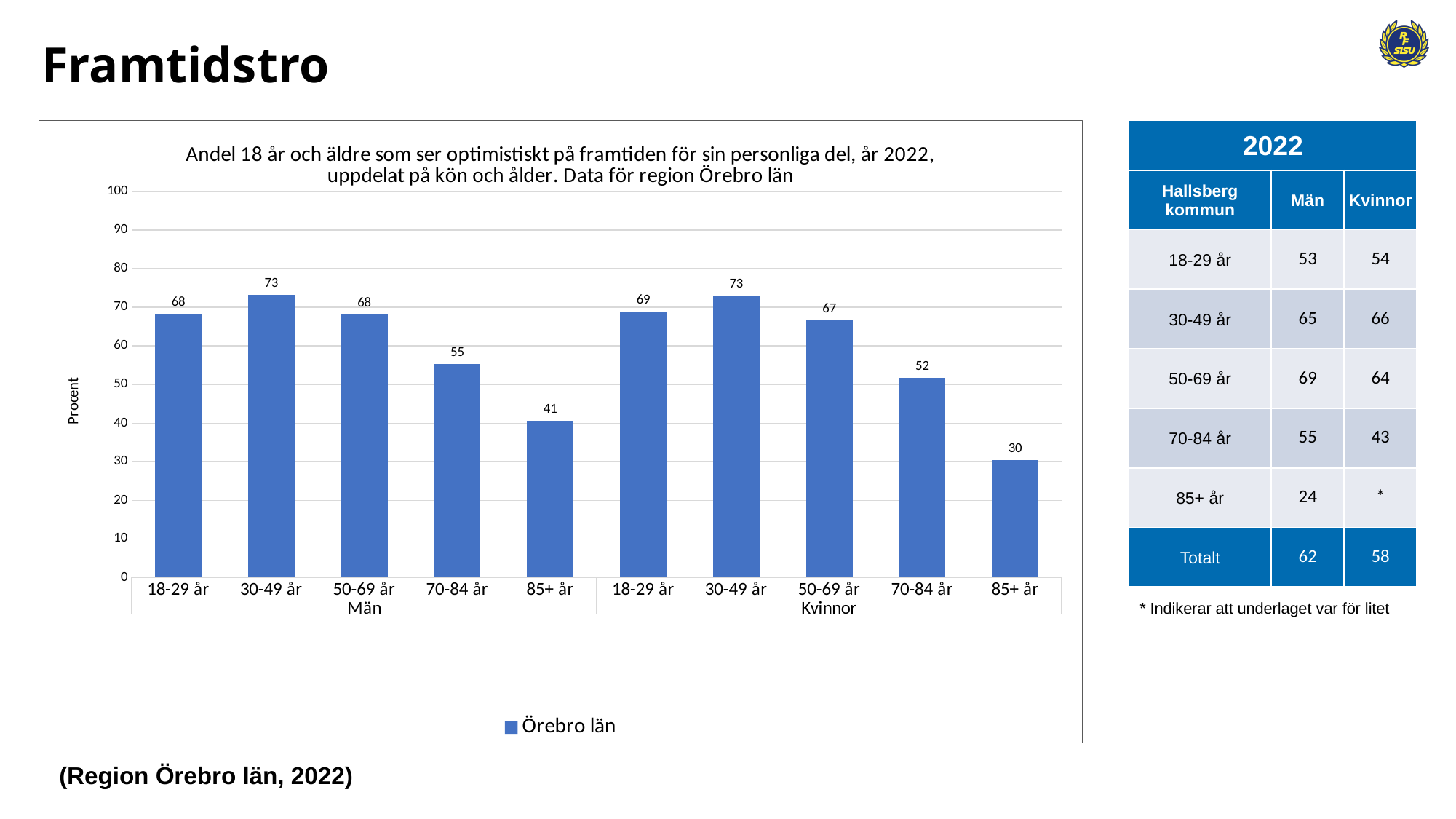
How many bars are plotted in the chart? 10 What is the value for 70-84 år among Män? 55 What is the difference between the values for 30-49 år and 70-84 år among Kvinnor? 21 What is the difference between the values for 85+ år among Män and 85+ år among Kvinnor? 11 Which bar has the lowest value in the chart? 85+ år (Kvinnor) What is the value for 85+ år among Kvinnor? 30 What is the value for 18-29 år among Kvinnor? 69 Which is larger: the value for 50-69 år among Män or 50-69 år among Kvinnor? 50-69 år among Män Which age group has the highest value among Män? 30-49 år How many series does the legend list? 1 What kind of chart is shown on the slide? Bar chart Among Kvinnor, do the values rise or fall from 30-49 år to 85+ år? Fall